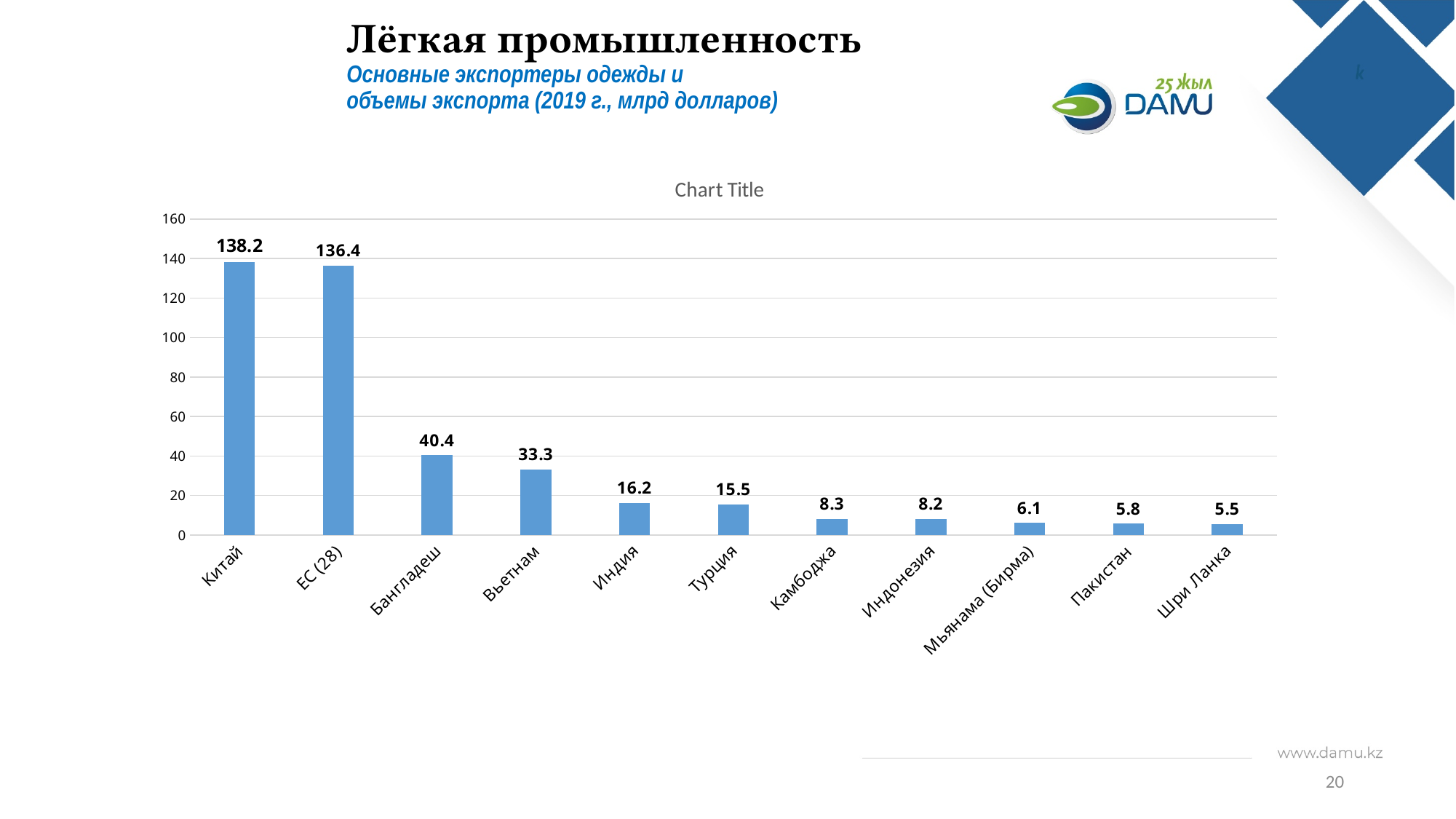
What is the value for Индонезия? 8.2 Do the values rise or fall from left to right along the x axis? Fall Which is larger, the value for Индия or the value for Турция? Индия How many categories are shown on the x axis? 11 What is the difference between the values for Китай and ЕС (28)? 1.8 What kind of chart is shown on the slide? Bar chart Which category has the lowest value? Шри Ланка Which category has the highest value? Китай What is the value for Мьянама (Бирма)? 6.1 What is the value for Бангладеш? 40.4 What is the difference between the values for Бангладеш and Вьетнам? 7.1 What is the value for Китай? 138.2